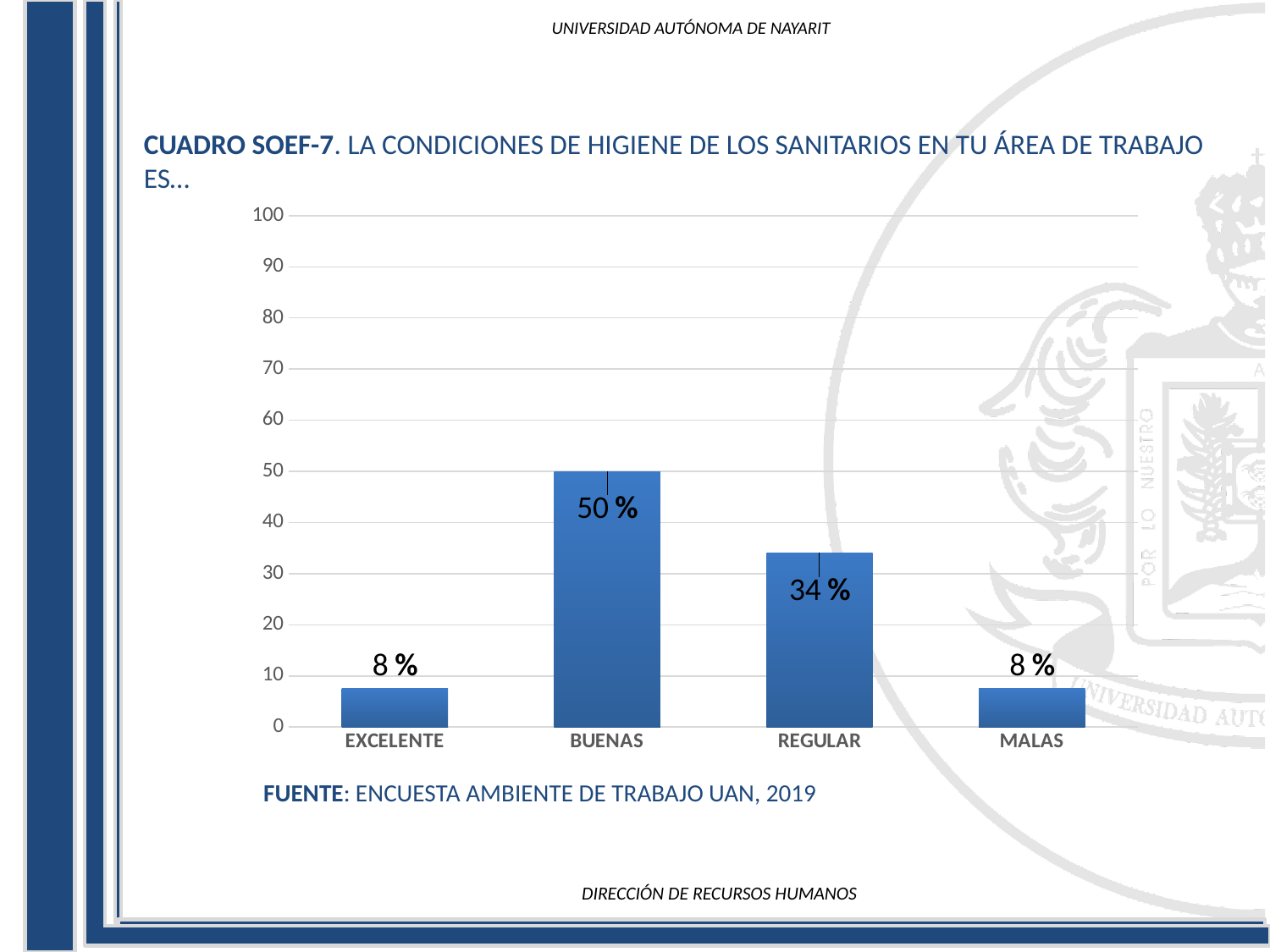
How many categories are shown on the x axis? 4 Is the value for BUENAS greater or less than 40? greater Which category has the highest value? BUENAS Which is larger, the value for REGULAR or the value for EXCELENTE? REGULAR What is the value for REGULAR? 34 % What is the difference between the values for BUENAS and REGULAR? 16 % What source is cited below the chart? ENCUESTA AMBIENTE DE TRABAJO UAN, 2019 What is the value for BUENAS? 50 % What is the difference between the values for REGULAR and MALAS? 26 % What is the value for EXCELENTE? 8 % What kind of chart is shown on the slide? Bar chart What is the value for MALAS? 8 %